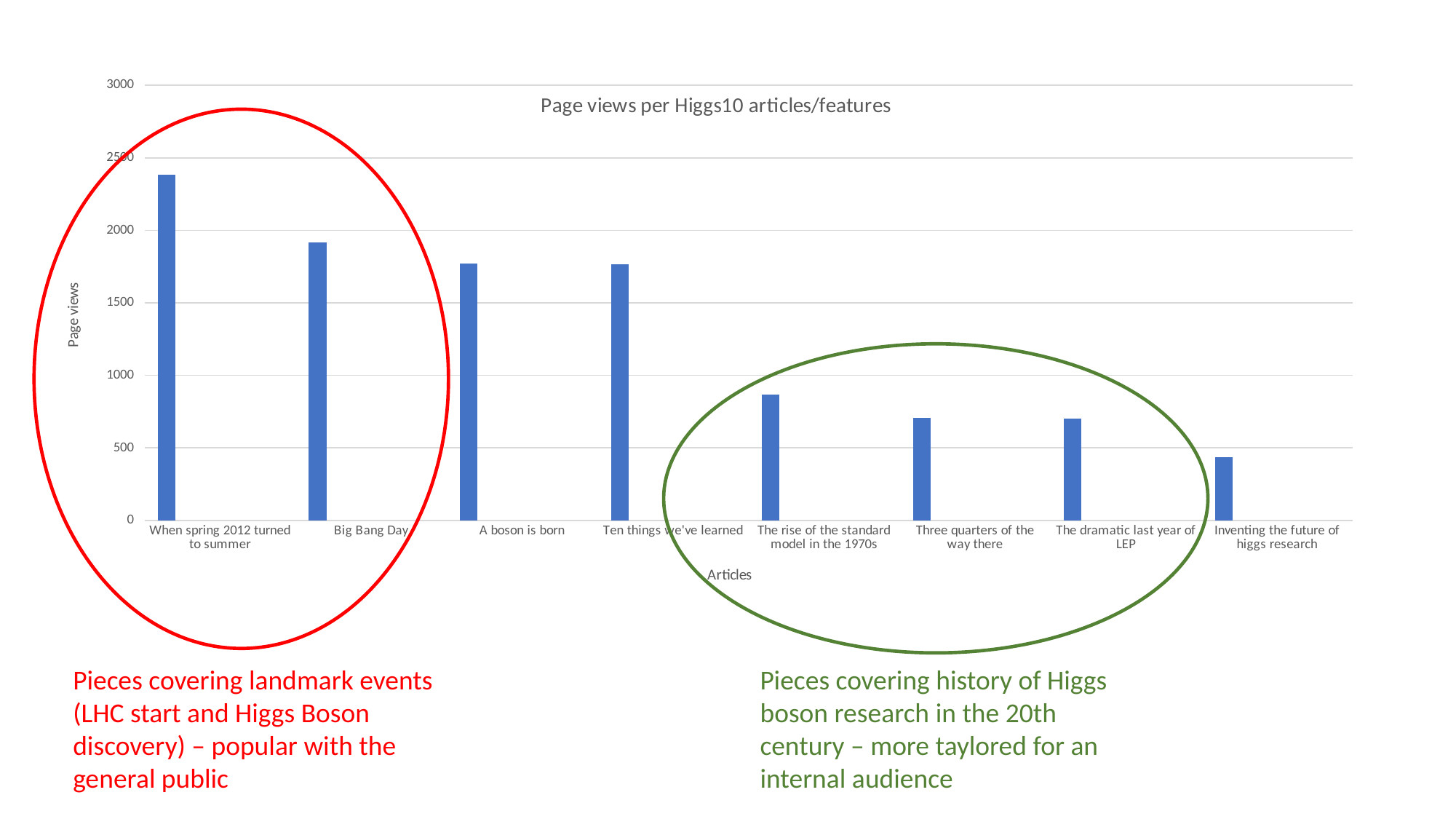
Which article has the lowest number of page views? Inventing the future of higgs research Do the page views generally rise or fall moving from left to right along the x axis? fall Is the value for "The rise of the standard model in the 1970s" greater or less than 1000? less Which article has the highest number of page views? When spring 2012 turned to summer Is the value for "Inventing the future of higgs research" greater or less than 500? less What kind of chart is shown on the slide? bar chart Is the value for "When spring 2012 turned to summer" greater or less than 2000? greater Which has more page views, "Big Bang Day" or "A boson is born"? Big Bang Day Which has more page views, "Three quarters of the way there" or "Inventing the future of higgs research"? Three quarters of the way there How many articles are plotted on the chart? 8 What is the title of the chart? Page views per Higgs10 articles/features